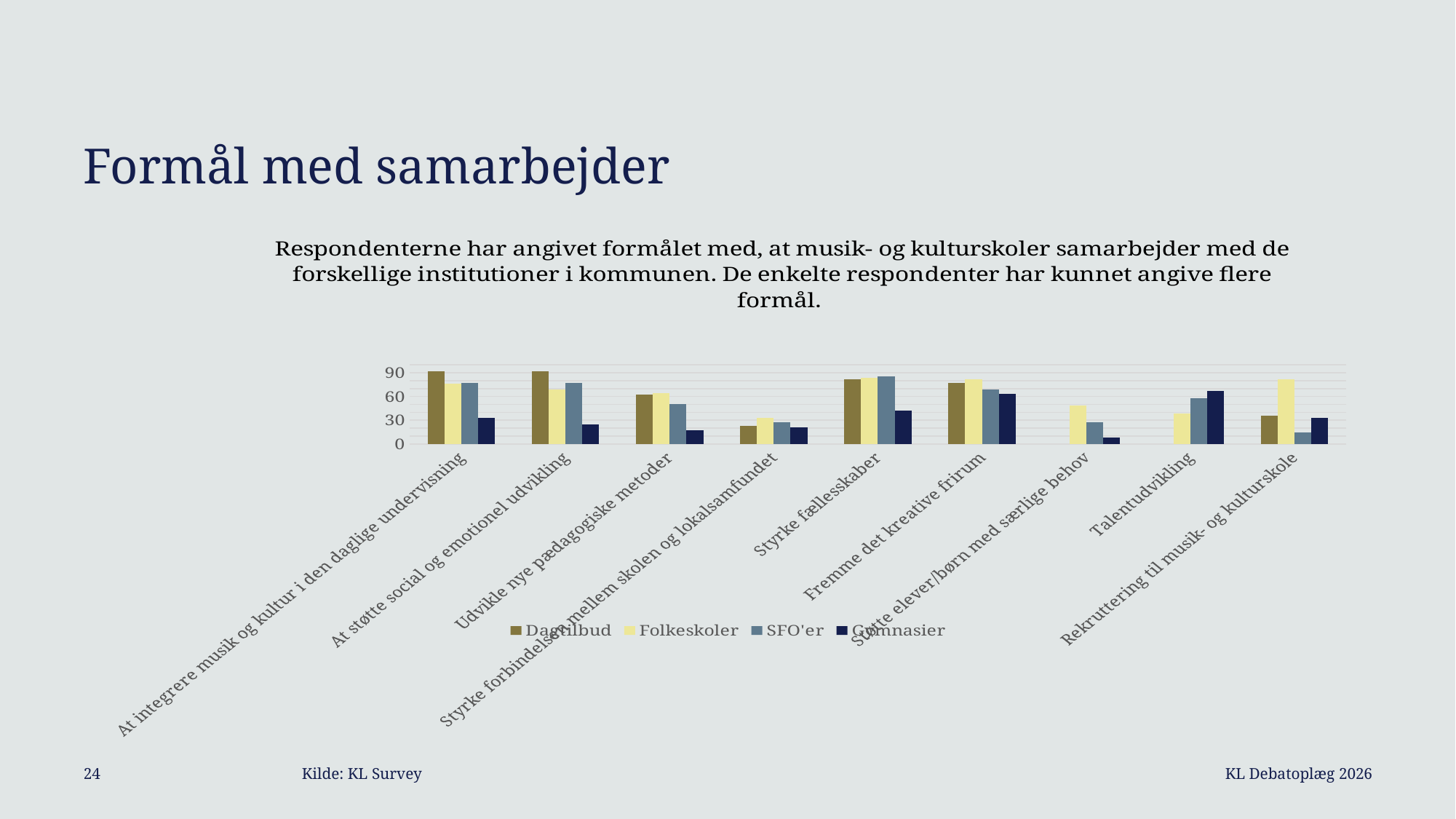
What is the title of the slide containing the chart? Formål med samarbejder How many series does the chart's legend list? 4 For 'At integrere musik og kultur i den daglige undervisning', which is larger: the Dagtilbud value or the Gymnasier value? Dagtilbud Is the SFO'er value for 'Rekruttering til musik- og kulturskole' greater or less than 30? less Which series has the lowest value for 'Støtte elever/børn med særlige behov'? Gymnasier How many categories are shown along the x axis of the chart? 9 What kind of chart is shown on the slide? Bar chart Is the Dagtilbud value for 'At integrere musik og kultur i den daglige undervisning' greater or less than 60? greater Is the Gymnasier value for 'Støtte elever/børn med særlige behov' greater or less than 30? less Which series are listed in the chart's legend? Dagtilbud, Folkeskoler, SFO'er, Gymnasier Which series has the highest value for 'Rekruttering til musik- og kulturskole'? Folkeskoler